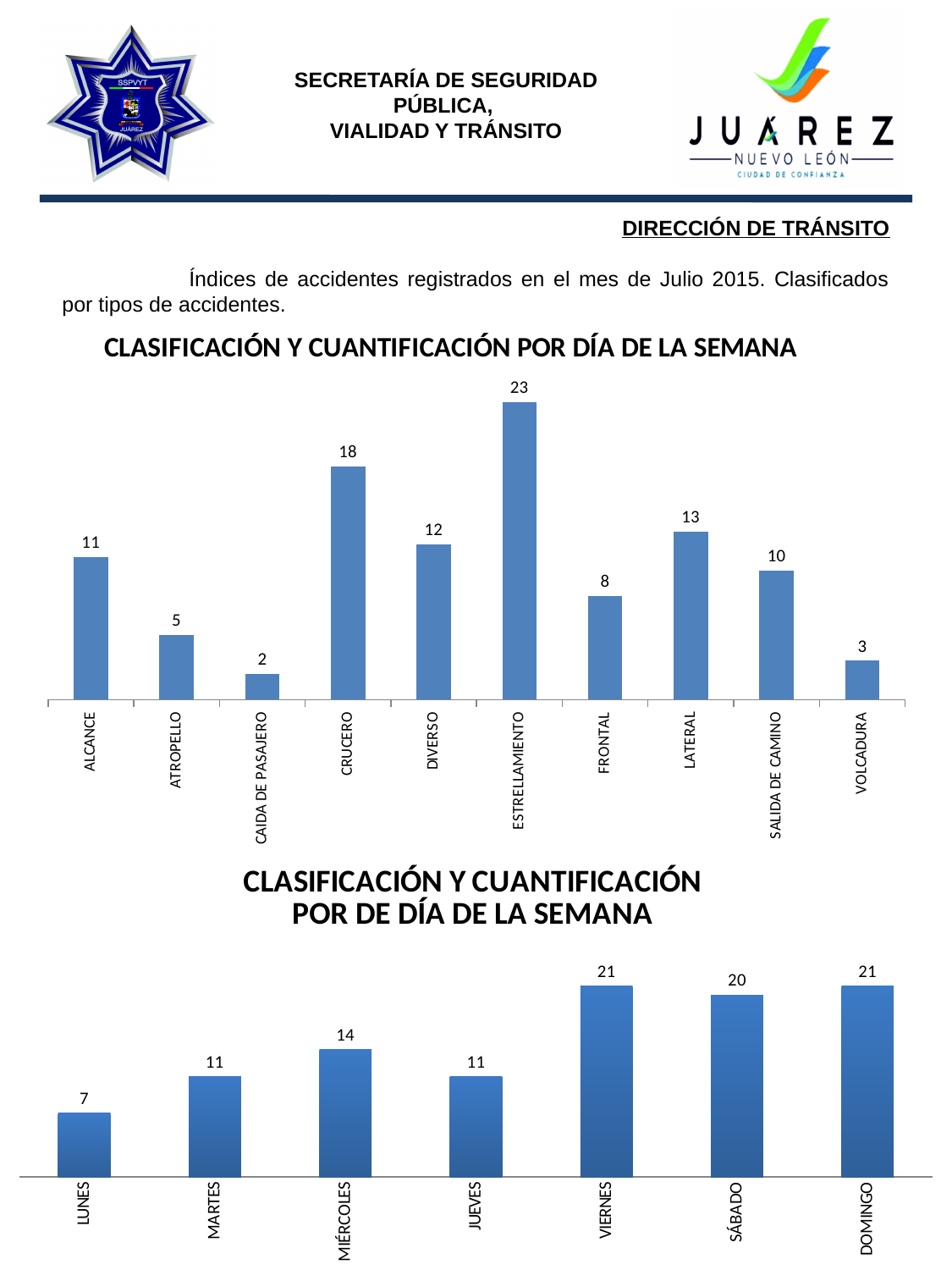
In the top chart, which category has the highest value? ESTRELLAMIENTO In the bottom chart, what is the value for MIÉRCOLES? 14 In the bottom chart, what is the difference between the values for VIERNES and SÁBADO? 1 In the top chart, what is the difference between the values for ESTRELLAMIENTO and FRONTAL? 15 How many categories are shown in the bottom chart? 7 In the top chart, what is the value for SALIDA DE CAMINO? 10 What type of chart is the bottom chart? Bar chart How many categories are shown in the top chart? 10 In the bottom chart, which day has the lowest value? LUNES In the top chart, which is larger, the value for LATERAL or the value for DIVERSO? LATERAL In the top chart, which category has the lowest value? CAIDA DE PASAJERO In the top chart, what is the value for CRUCERO? 18